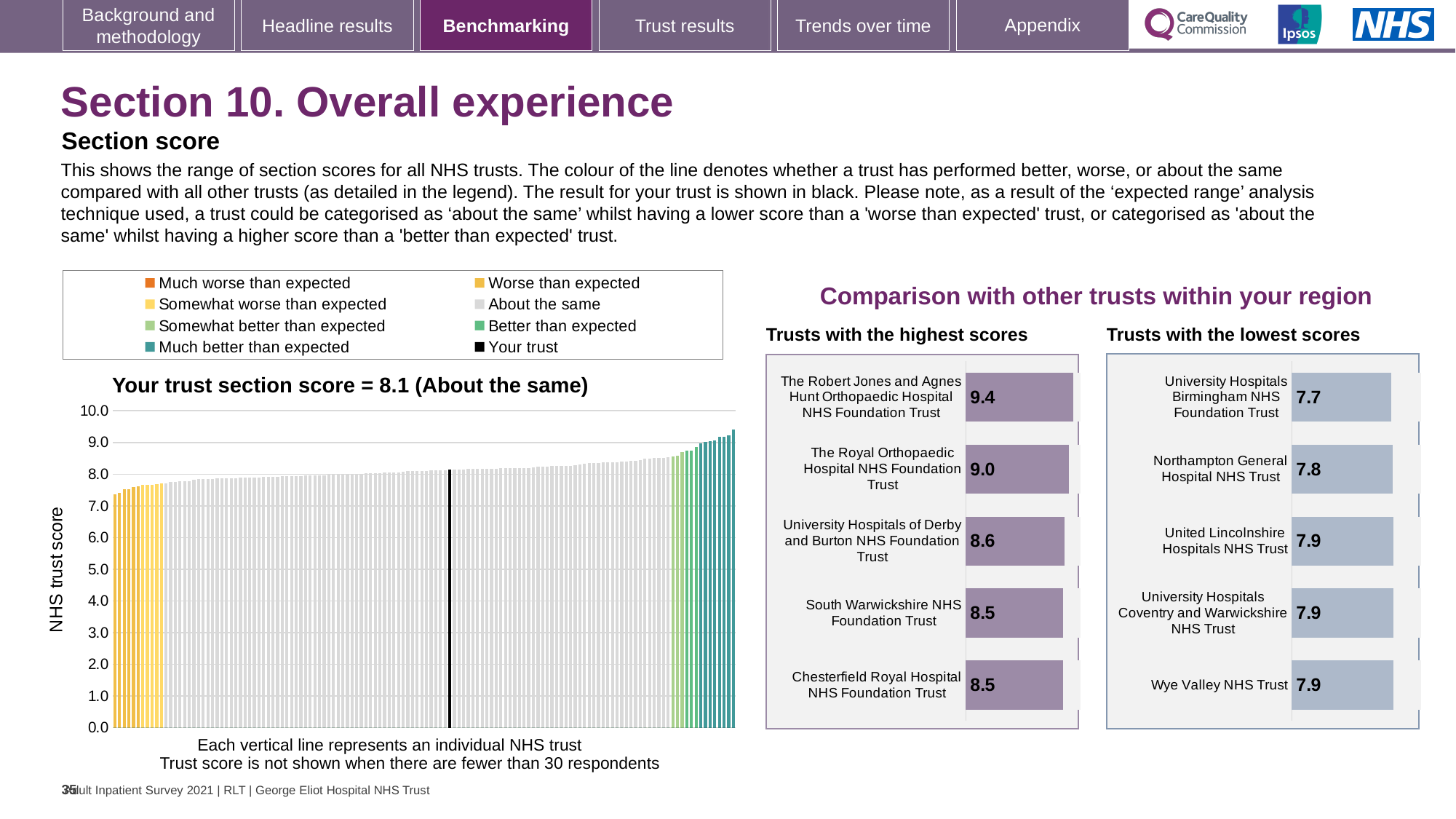
What kind of chart is the 'Your trust section score' chart? Bar chart In the 'Trusts with the highest scores' chart, what is the score for The Robert Jones and Agnes Hunt Orthopaedic Hospital NHS Foundation Trust? 9.4 In the 'Trusts with the lowest scores' chart, what is the difference between the scores of United Lincolnshire Hospitals NHS Trust and University Hospitals Birmingham NHS Foundation Trust? 0.2 In the 'Trusts with the lowest scores' chart, what is the score for Northampton General Hospital NHS Trust? 7.8 In the 'Trusts with the highest scores' chart, which trust has the highest score? The Robert Jones and Agnes Hunt Orthopaedic Hospital NHS Foundation Trust In the 'Trusts with the highest scores' chart, how many trusts are listed? 5 In the 'Trusts with the lowest scores' chart, which is larger: the score for Wye Valley NHS Trust or the score for University Hospitals Birmingham NHS Foundation Trust? Wye Valley NHS Trust In the 'Trusts with the highest scores' chart, what is the difference between the scores of The Royal Orthopaedic Hospital NHS Foundation Trust and University Hospitals of Derby and Burton NHS Foundation Trust? 0.4 In the 'Trusts with the lowest scores' chart, which trust has the lowest score? University Hospitals Birmingham NHS Foundation Trust In the 'Your trust section score' chart, is the value of the lowest-scoring trust greater or less than 7.0? greater In the 'Your trust section score' chart, what is the section score for your trust? 8.1 How many entries does the legend above the 'Your trust section score' chart list? 8